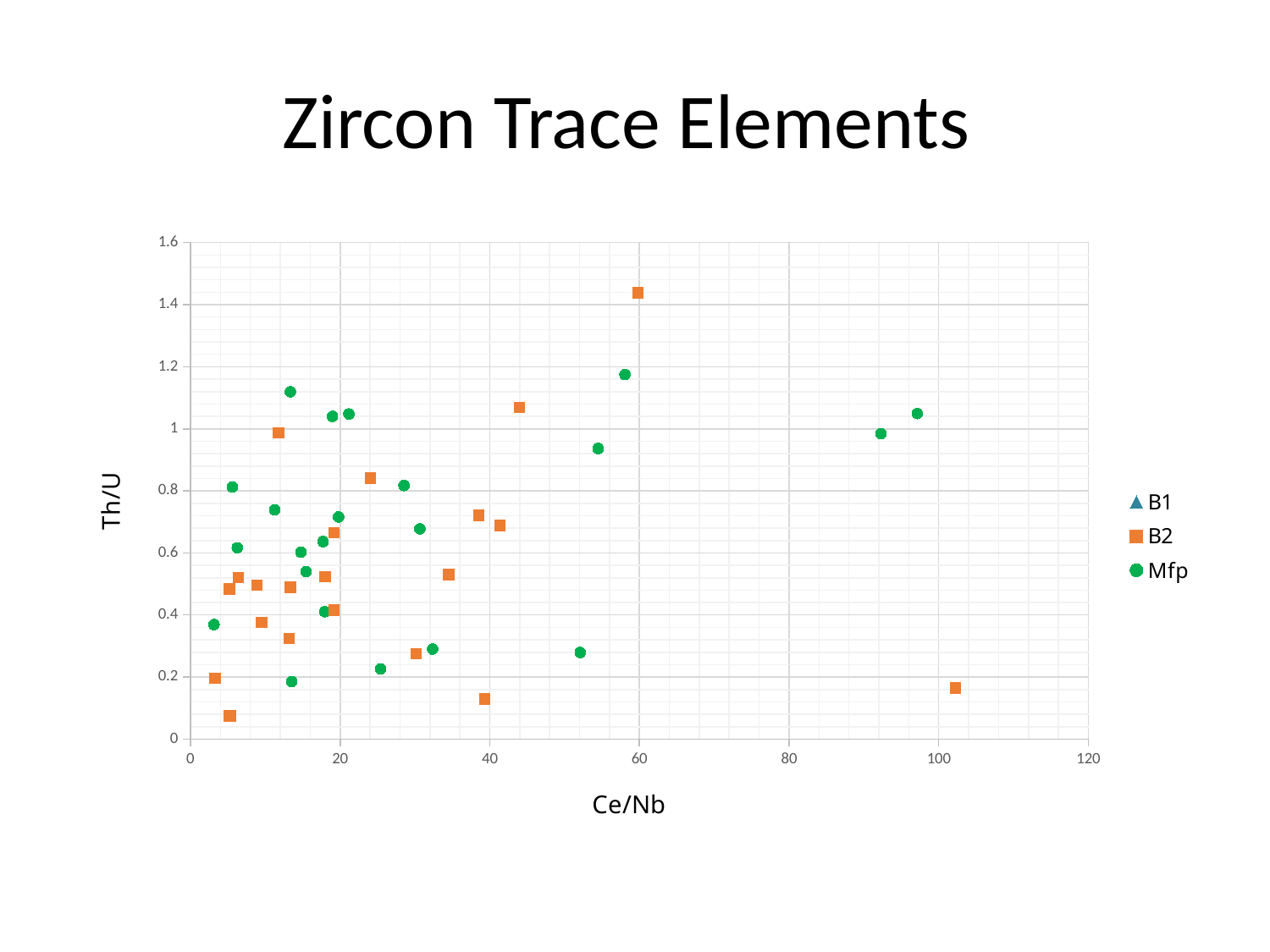
Is the Th/U value of the highest B2 point greater or less than 1.2? greater What is the label on the horizontal axis? Ce/Nb What kind of chart is shown on the slide? Scatter chart Is the Th/U value of the highest Mfp point greater or less than 1? greater Is the Th/U value of the B2 point with the highest Ce/Nb greater or less than 0.4? less Which series has the point with the lowest Th/U value? B2 How many series does the legend list? 3 Which series has the point with the highest Th/U value? B2 What is the title of the chart? Zircon Trace Elements Which series has the point with the highest Ce/Nb value? B2